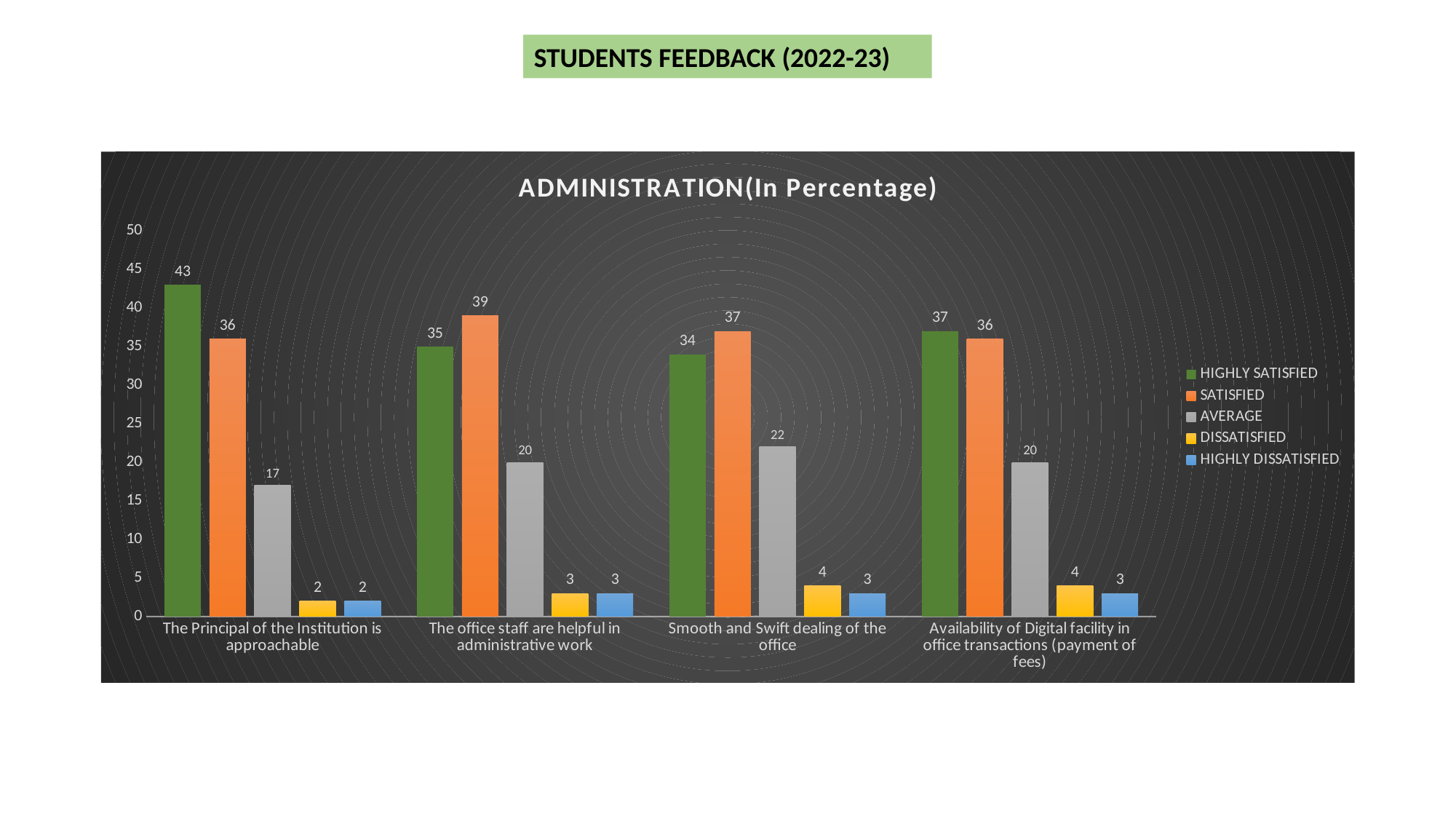
How many categories are shown on the x axis? 4 What is the AVERAGE value for 'Smooth and Swift dealing of the office'? 22 What is the DISSATISFIED value for 'Availability of Digital facility in office transactions (payment of fees)'? 4 What is the HIGHLY SATISFIED value for 'The Principal of the Institution is approachable'? 43 For 'Smooth and Swift dealing of the office', which is larger: HIGHLY SATISFIED or SATISFIED? SATISFIED How many series does the legend list? 5 What kind of chart is shown on the slide? Bar chart Which category has the highest HIGHLY SATISFIED value? The Principal of the Institution is approachable What is the difference between the HIGHLY SATISFIED and SATISFIED values for 'The Principal of the Institution is approachable'? 7 What is the SATISFIED value for 'The office staff are helpful in administrative work'? 39 Which category has the lowest AVERAGE value? The Principal of the Institution is approachable What is the title of the chart? ADMINISTRATION(In Percentage)